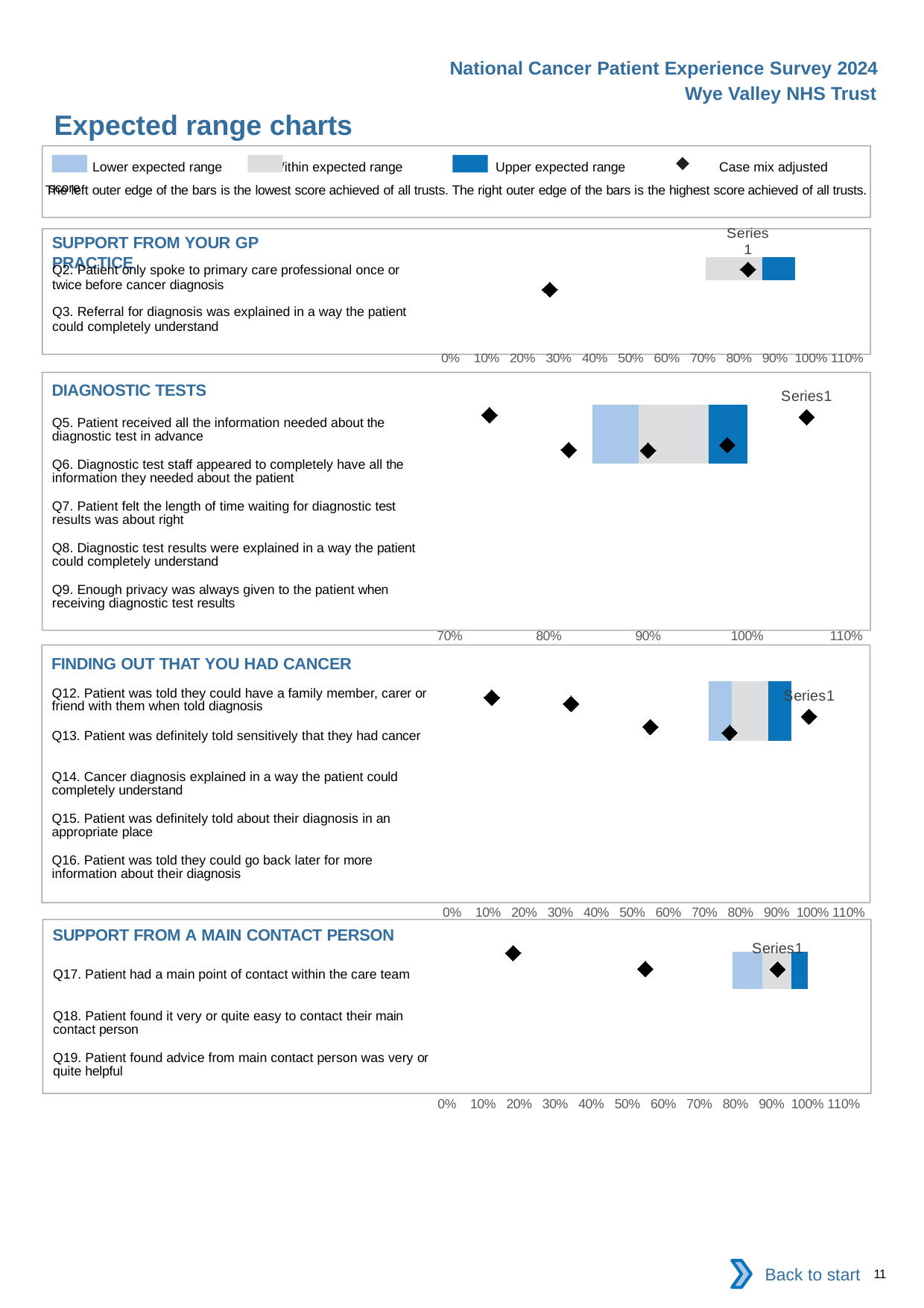
What is the highest axis tick shown on the 'SUPPORT FROM A MAIN CONTACT PERSON' chart? 110% How many questions are listed in the 'FINDING OUT THAT YOU HAD CANCER' chart? 5 What is the title of the slide? Expected range charts What is the lowest axis tick shown on the 'DIAGNOSTIC TESTS' chart? 70% What kind of chart is used in the 'DIAGNOSTIC TESTS' section? Bar chart How many questions are listed in the 'SUPPORT FROM A MAIN CONTACT PERSON' chart? 3 In the legend, which range is shown in the darkest blue colour? Upper expected range How many questions are listed in the 'SUPPORT FROM YOUR GP PRACTICE' chart? 2 How many entries does the legend at the top of the slide list? 4